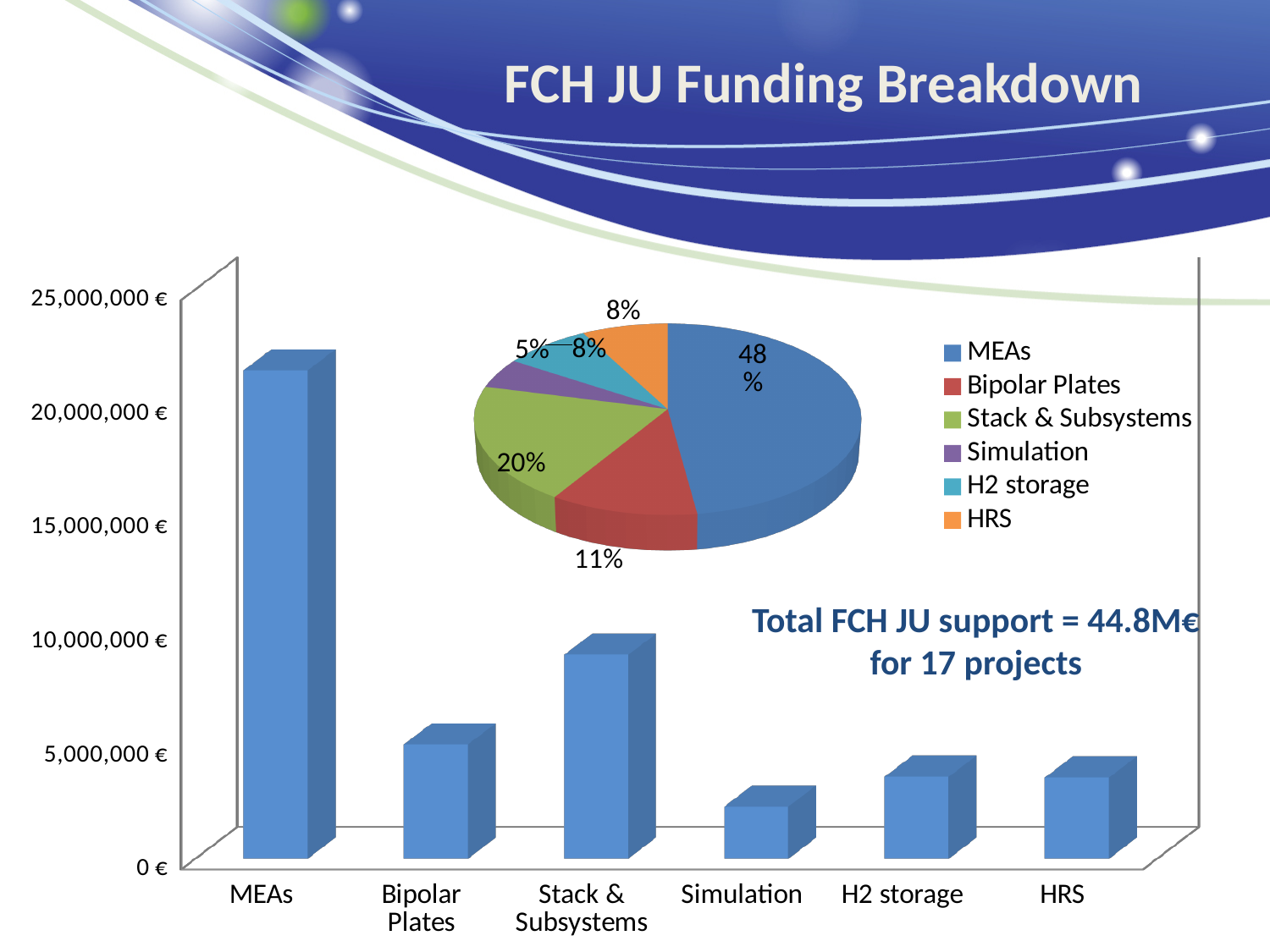
In the pie chart, what share of funding goes to Simulation? 5% In the pie chart, what share of funding goes to Stack & Subsystems? 20% In the pie chart, how many percentage points larger is the MEAs share than the Stack & Subsystems share? 28% In the bar chart, is the value for MEAs greater or less than 20,000,000 €? greater In the pie chart, what share of funding goes to Bipolar Plates? 11% In the pie chart, how many categories does the legend list? 6 In the pie chart, which category has the largest slice? MEAs In the bar chart, which category has the tallest bar? MEAs In the pie chart, which category has the smallest slice? Simulation What kind of chart is the large chart on the left of the slide? Bar chart In the bar chart, which is larger: Stack & Subsystems or Bipolar Plates? Stack & Subsystems